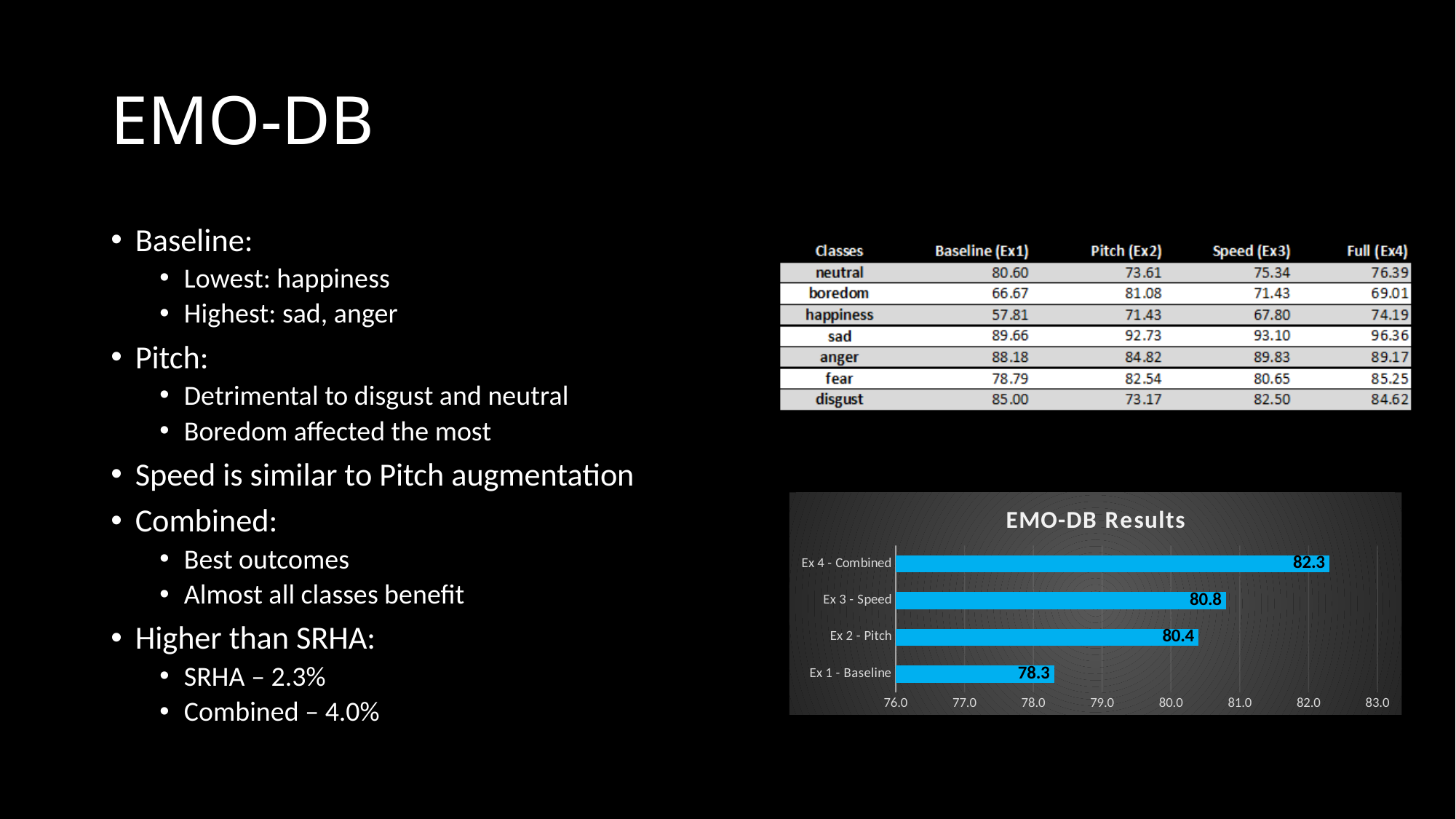
Which category has the lowest value in the EMO-DB Results chart? Ex 1 - Baseline What kind of chart is the EMO-DB Results chart? bar chart What is the value for Ex 1 - Baseline in the EMO-DB Results chart? 78.3 What is the title of the chart on the slide? EMO-DB Results What is the value for Ex 3 - Speed in the EMO-DB Results chart? 80.8 What is the value for Ex 4 - Combined in the EMO-DB Results chart? 82.3 In the EMO-DB Results chart, which is larger: the value for Ex 3 - Speed or the value for Ex 2 - Pitch? Ex 3 - Speed Which category has the highest value in the EMO-DB Results chart? Ex 4 - Combined What is the value for Ex 2 - Pitch in the EMO-DB Results chart? 80.4 What is the difference between the values for Ex 4 - Combined and Ex 1 - Baseline in the EMO-DB Results chart? 4.0 How many categories are shown in the EMO-DB Results chart? 4 In the EMO-DB Results chart, is the value for Ex 1 - Baseline greater or less than 80.0? less